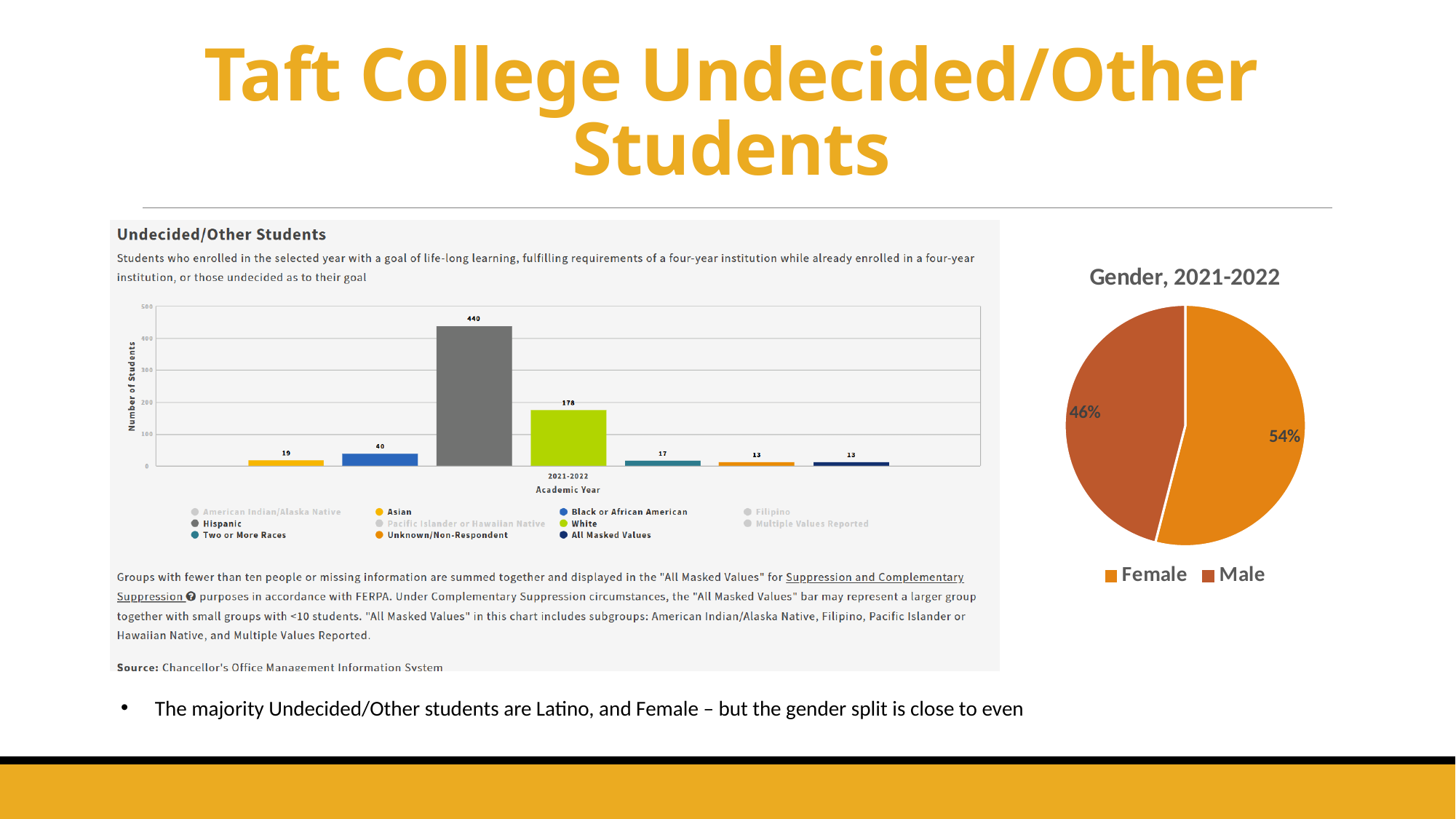
In the Undecided/Other Students bar chart, what is the value for White students? 178 What kind of chart is the Undecided/Other Students chart? Bar chart In the Undecided/Other Students bar chart, how many bars are plotted? 7 In the Gender, 2021-2022 pie chart, what share is Male? 46% In the Undecided/Other Students bar chart, which group has the highest number of students? Hispanic In the Undecided/Other Students bar chart, what is the value for Black or African American students? 40 In the Undecided/Other Students bar chart, how many students are Hispanic? 440 In the Undecided/Other Students bar chart, what is the difference between the Hispanic and White values? 262 What kind of chart is the Gender, 2021-2022 chart? Pie chart In the Undecided/Other Students bar chart, which is larger: Asian or Two or More Races? Asian In the Gender, 2021-2022 pie chart, what share is Female? 54% In the Undecided/Other Students bar chart, what academic year is shown on the x axis? 2021-2022